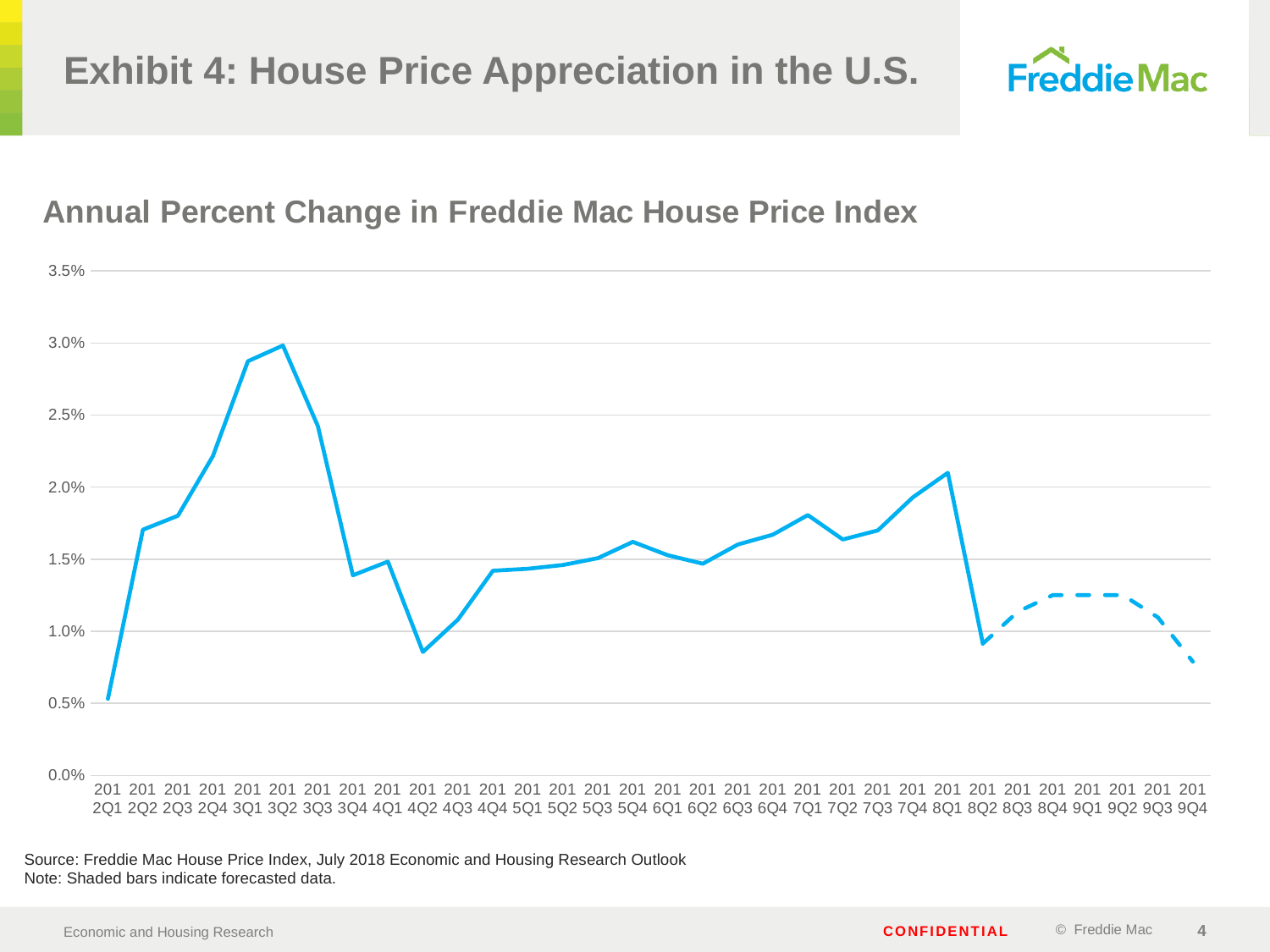
Which quarter has the lowest annual percent change? 2012Q1 Is the value for 2014Q2 greater or less than 1.0%? less Is the value for 2012Q1 greater or less than 1.0%? less Which is larger, the value for 2013Q2 or the value for 2018Q1? 2013Q2 How many quarterly data points are plotted on the x axis? 32 What kind of chart is shown on the slide? Line chart Do the values rise or fall from 2012Q1 to 2013Q2? rise Which quarter has the highest annual percent change? 2013Q2 Is the value for 2013Q3 greater or less than 2.0%? greater Which is larger, the value for 2013Q1 or the value for 2014Q2? 2013Q1 What is the title of the chart? Annual Percent Change in Freddie Mac House Price Index